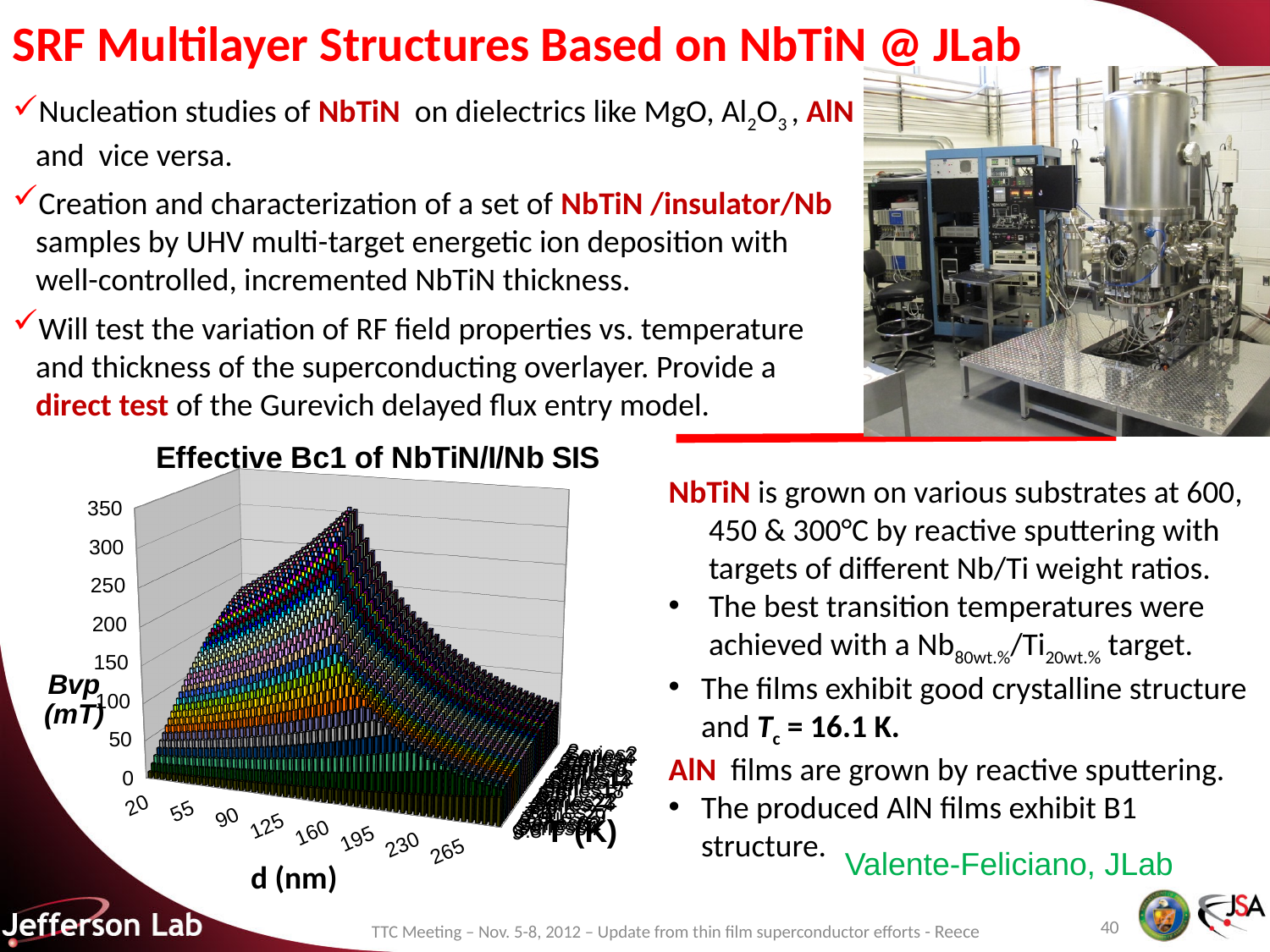
What is the highest tick value shown on the d (nm) axis? 265 Is the highest value plotted in the chart greater or less than 200? greater What is the highest tick value shown on the Bvp (mT) axis? 350 How many tick labels are shown on the d (nm) axis of the chart? 8 Do the values in the chart rise or fall as d increases from 20 nm to 125 nm? rise Do the values in the chart rise or fall as d increases from 195 nm to 265 nm? fall What is the lowest tick value shown on the d (nm) axis? 20 What is the label of the vertical axis of the chart? Bvp (mT) What is the title of the chart on the slide? Effective Bc1 of NbTiN/I/Nb SIS What kind of chart is shown on the slide? bar chart